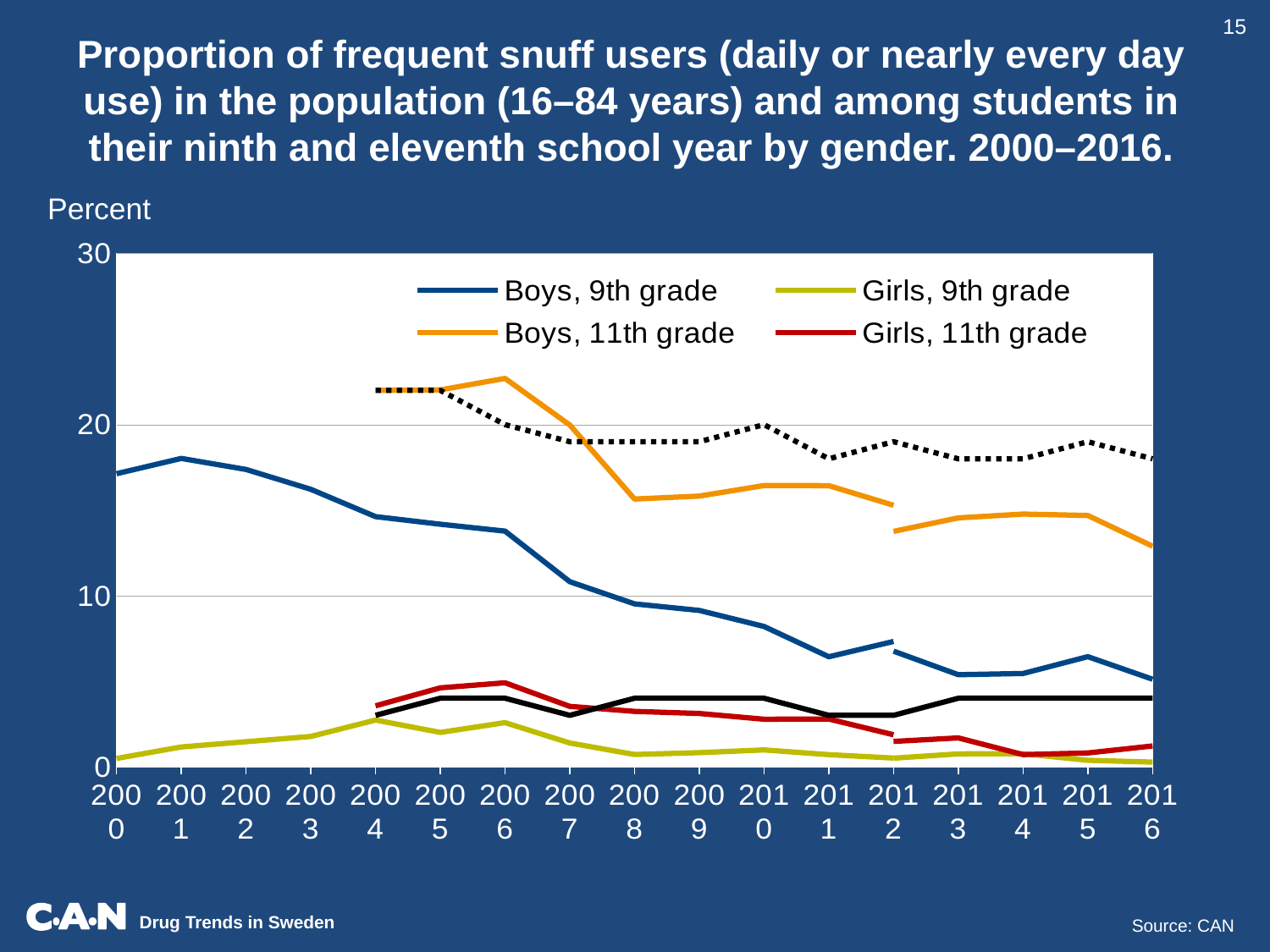
Is the value for Boys, 9th grade in 2000 greater or less than 10? greater Does the value for Boys, 9th grade rise or fall from 2000 to 2016? fall Is the value for Boys, 11th grade in 2006 greater or less than 20? greater How many series does the legend list? 4 In 2006, which is larger: Girls, 11th grade or Girls, 9th grade? Girls, 11th grade In 2010, which is larger: Boys, 11th grade or Boys, 9th grade? Boys, 11th grade Which legend series has the highest value in 2016? Boys, 11th grade Is the value for Boys, 9th grade in 2016 greater or less than 10? less What is the label on the vertical axis? Percent What kind of chart is shown on the slide? line chart How many years are shown along the x axis? 17